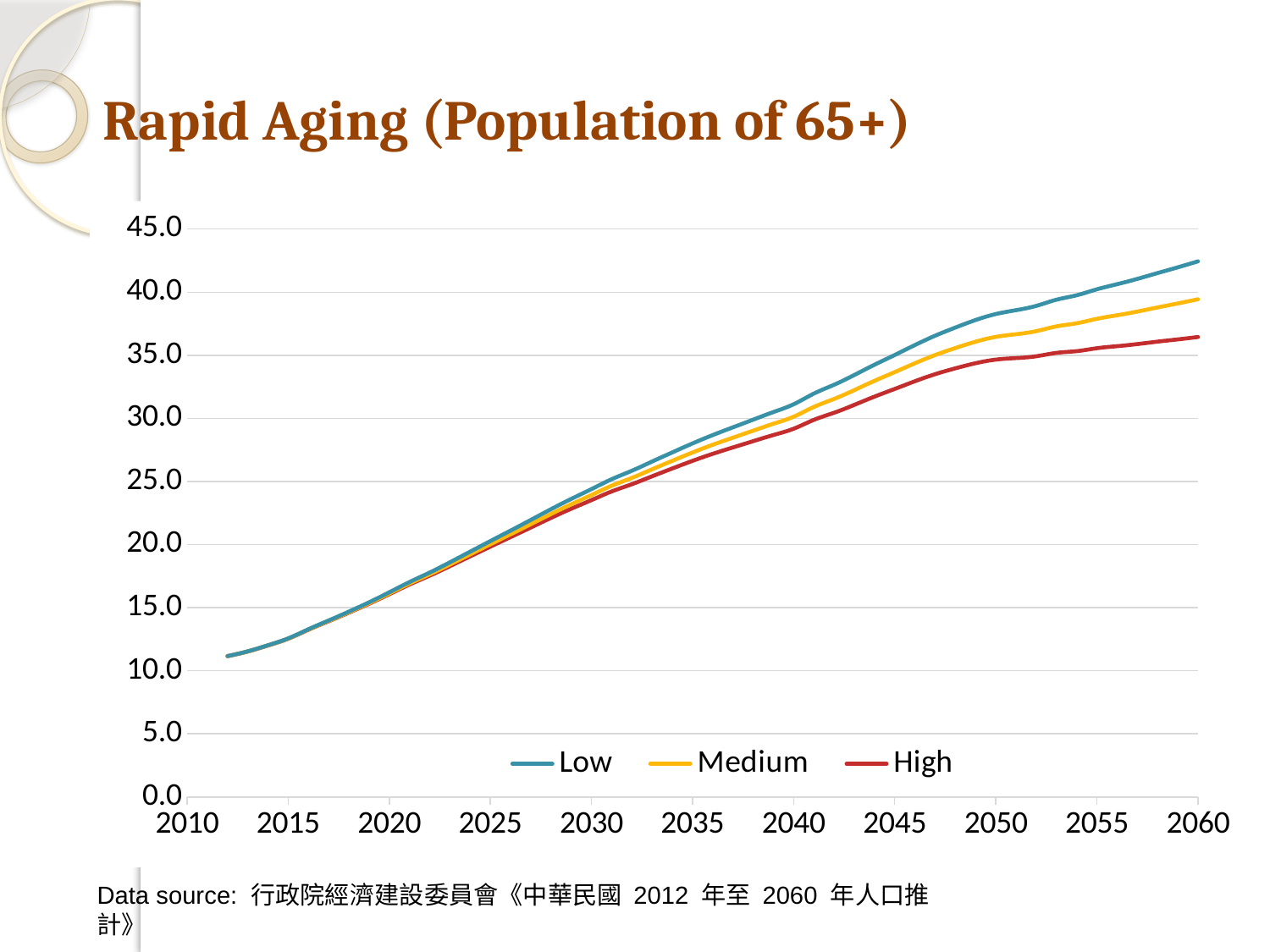
Is the value for the Low series in 2050 greater or less than 35.0? greater Do the values of the Low series rise or fall from 2012 to 2060? rise Do the values of the High series rise or fall over the years shown? rise What is the title of the slide containing the chart? Rapid Aging (Population of 65+) In 2060, which is larger, the Low series or the High series? Low Which series has the highest value in 2060? Low What kind of chart is shown on the slide? line chart Is the value for the Low series in 2060 greater or less than 40.0? greater Which series has the lowest value in 2060? High Is the value for the High series in 2060 greater or less than 40.0? less How many series does the legend list? 3